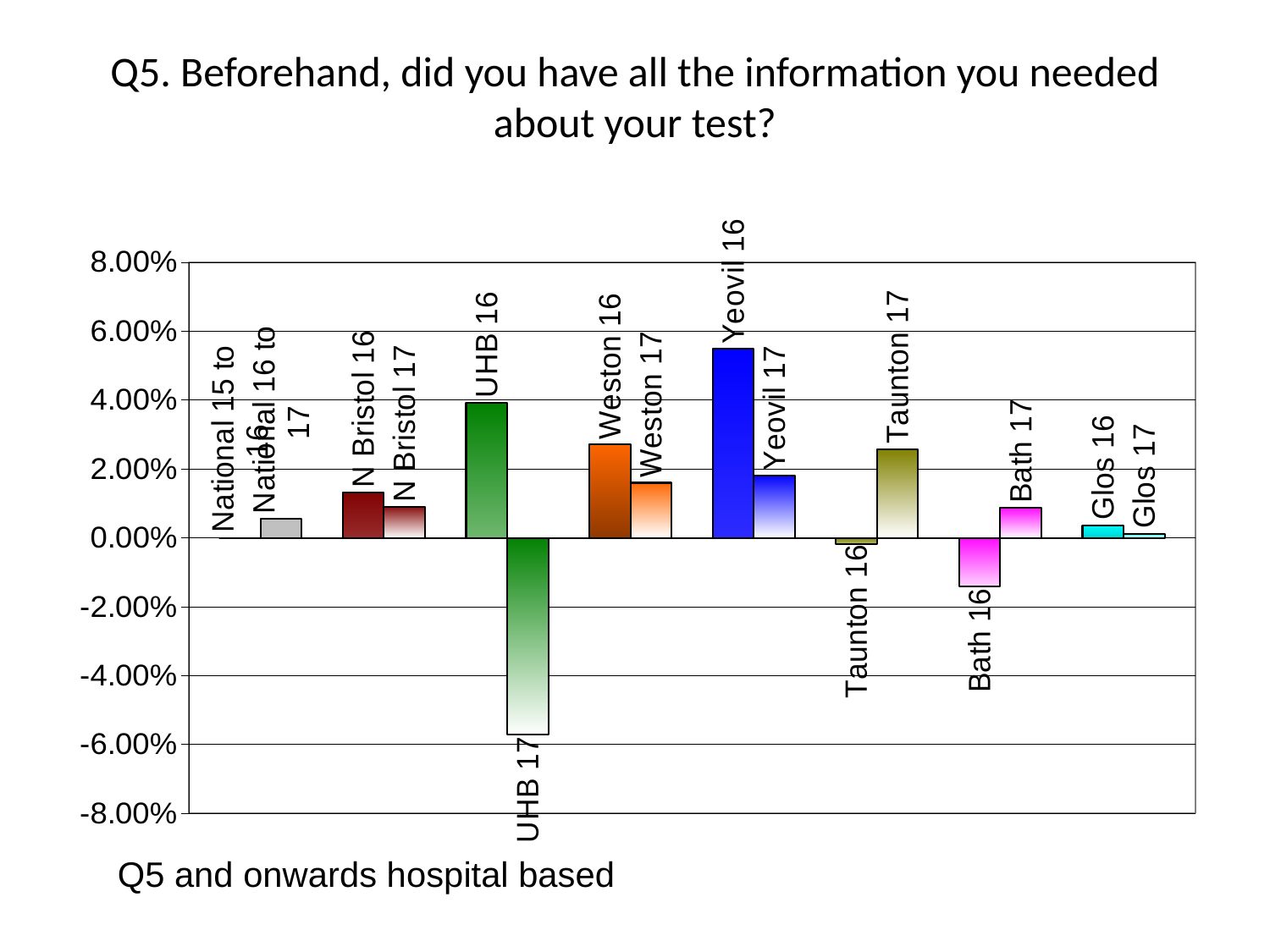
Which category has the highest value? Yeovil 16 What kind of chart is shown on the slide? bar chart Which is larger, the value for Weston 16 or the value for Weston 17? Weston 16 Is the value for UHB 17 greater or less than -4.00%? less Is the value for UHB 16 greater or less than 2.00%? greater Is the value for Yeovil 16 greater or less than 4.00%? greater Which category has the lowest value? UHB 17 Which is larger, the value for Taunton 17 or the value for Taunton 16? Taunton 17 What is the title of the slide? Q5. Beforehand, did you have all the information you needed about your test? How many categories are labelled on the chart? 16